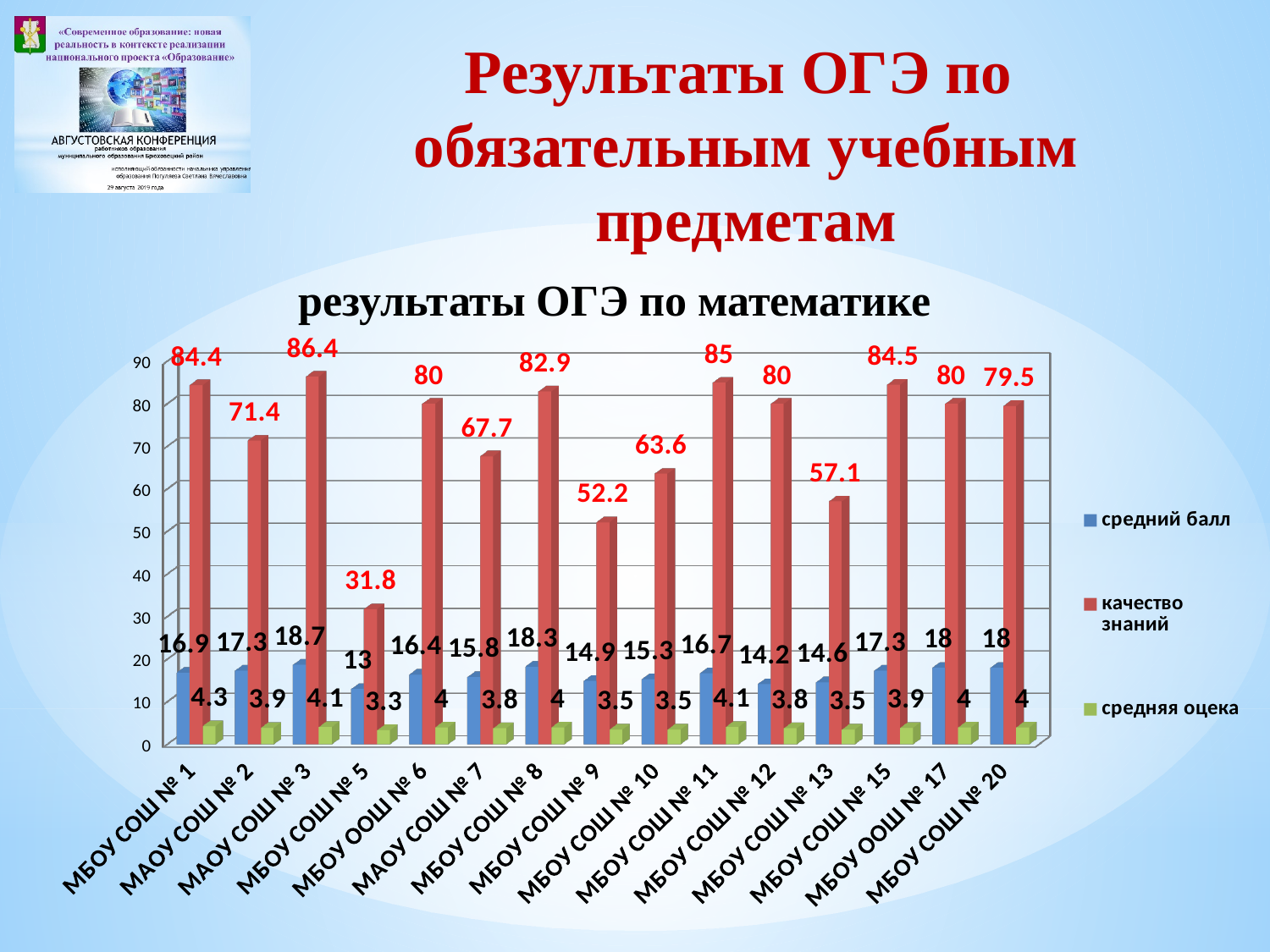
How many series does the legend list? 3 Is the качество знаний for МБОУ СОШ № 13 greater or less than 60? less What kind of chart is shown? bar chart What is the средняя оцека for МБОУ СОШ № 1? 4.3 Which school has the highest качество знаний? МАОУ СОШ № 3 What is the средний балл for МАОУ СОШ № 3? 18.7 Which has a higher качество знаний, МБОУ СОШ № 9 or МБОУ СОШ № 10? МБОУ СОШ № 10 What is the value of качество знаний for МБОУ СОШ № 5? 31.8 Which school has the lowest средний балл? МБОУ СОШ № 5 What is the title of the chart? результаты ОГЭ по математике How many schools are shown on the x axis? 15 What is the difference in качество знаний between МАОУ СОШ № 3 and МБОУ СОШ № 5? 54.6